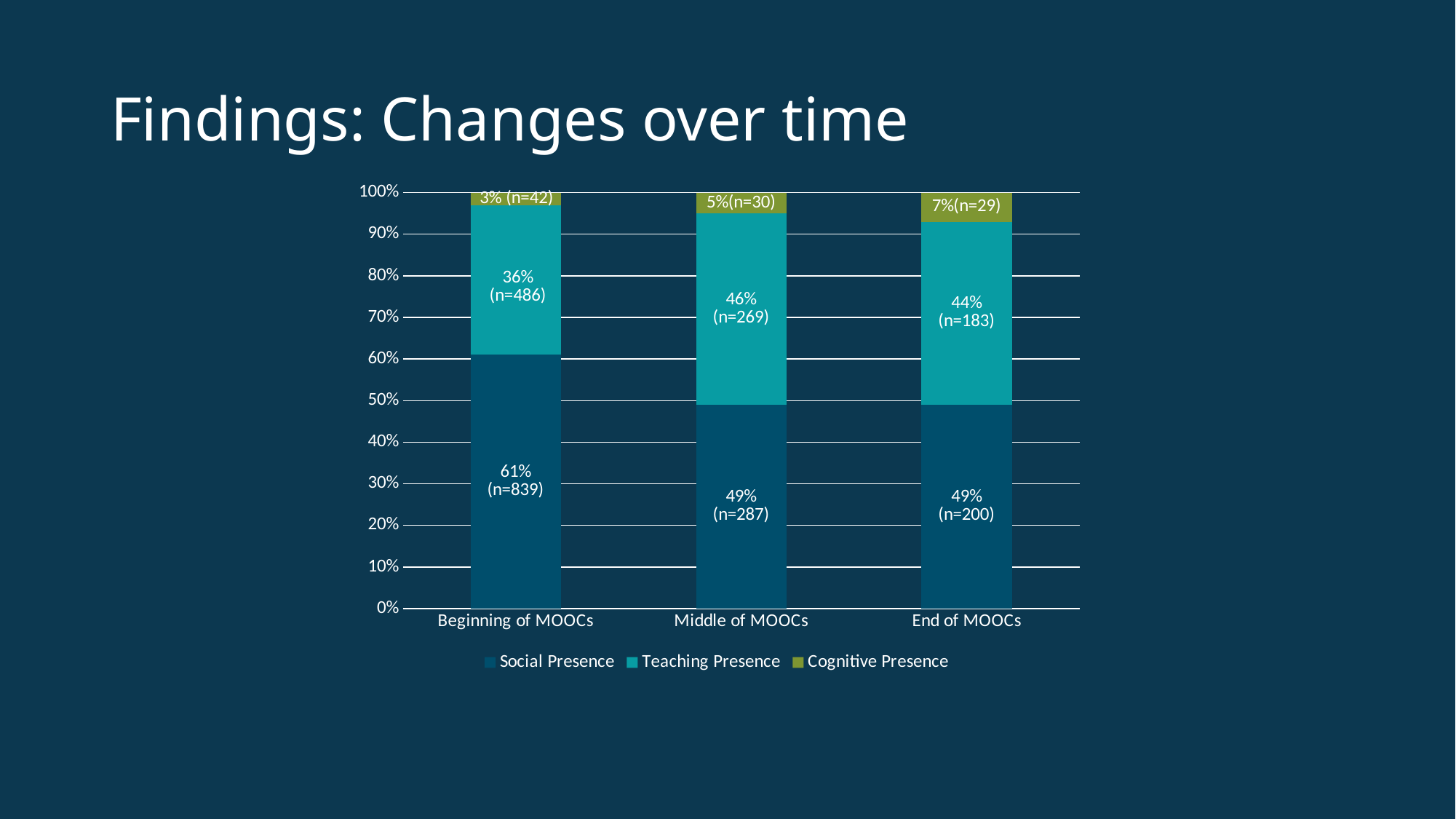
What percentage does Cognitive Presence account for at the End of MOOCs? 7% At which stage of MOOCs is the Social Presence percentage highest? Beginning of MOOCs What is the title of the slide? Findings: Changes over time How many series does the legend list? 3 At which stage of MOOCs is the Cognitive Presence percentage lowest? Beginning of MOOCs What kind of chart is shown on the slide? Stacked bar chart What percentage does Social Presence account for at the Beginning of MOOCs? 61% Does the Cognitive Presence percentage rise or fall from the Beginning to the End of MOOCs? Rise What is the n value for Teaching Presence in the Middle of MOOCs? n=269 How many stages of MOOCs are shown on the x axis? 3 Which is larger: the Teaching Presence percentage in the Middle of MOOCs or at the End of MOOCs? Middle of MOOCs What is the difference in Teaching Presence percentage between the Middle of MOOCs and the Beginning of MOOCs? 10%